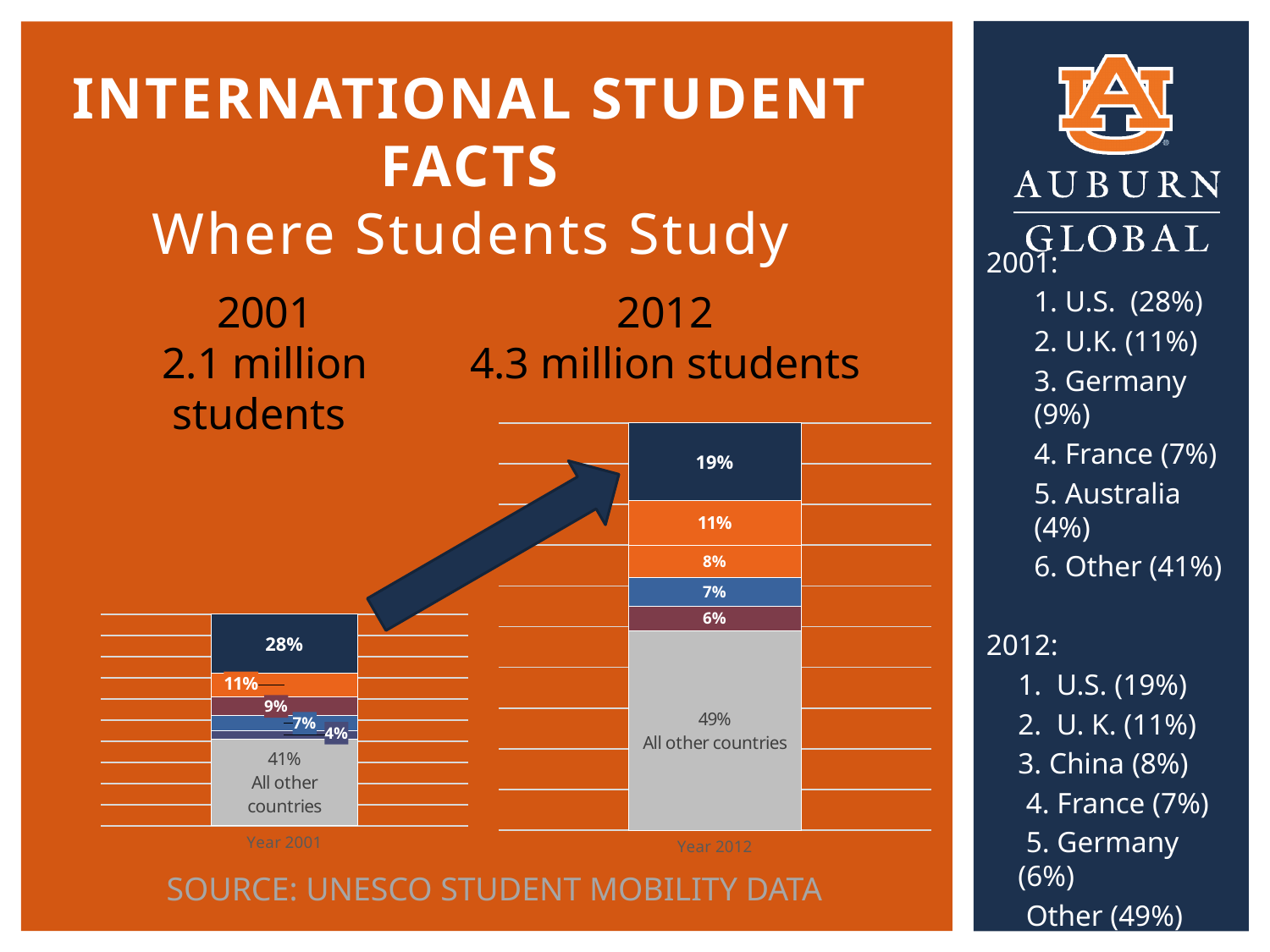
In the Year 2001 chart, what value is shown for the 'All other countries' segment? 41% What is the total of all the labeled segments in the Year 2012 bar? 100% In the Year 2012 chart, what value is shown for the 'All other countries' segment? 49% What is the difference between the 'All other countries' segment in the Year 2012 chart and the one in the Year 2001 chart? 8 percentage points In the Year 2012 chart, which segment is the largest? All other countries (49%) What kind of chart is used for the Year 2001 and Year 2012 data on this slide? Stacked bar chart In the Year 2001 chart, what is the value of the smallest segment? 4% In the Year 2001 chart, what value is shown for the top (dark navy) segment of the bar? 28% What is the difference between the top segment of the Year 2001 bar (28%) and the top segment of the Year 2012 bar (19%)? 9 percentage points How many segments make up the bar in the Year 2001 chart? 6 In the Year 2012 chart, what value is shown for the top (dark navy) segment of the bar? 19% Is the 'All other countries' segment larger in the Year 2001 chart or the Year 2012 chart? Year 2012